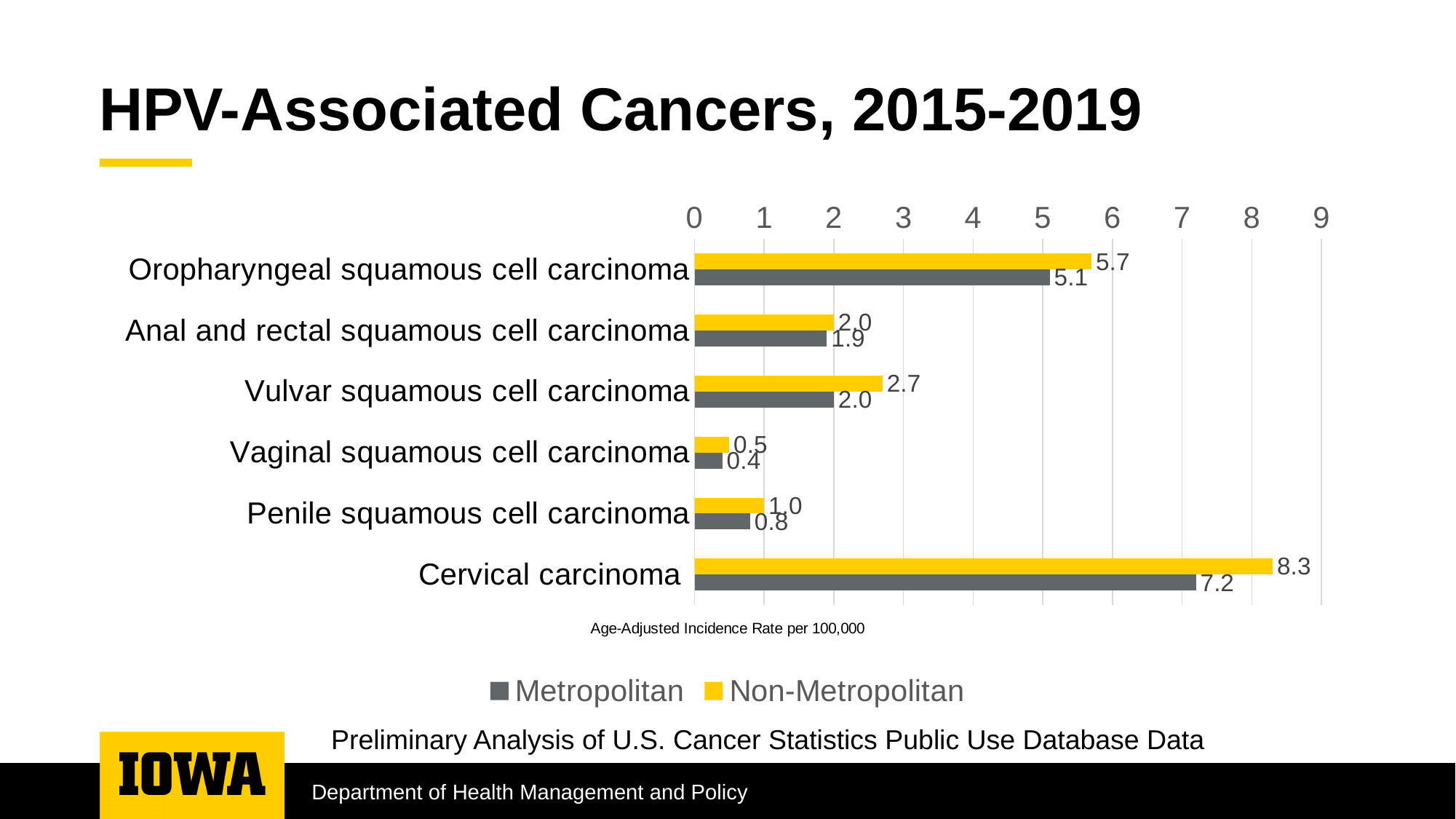
How many cancer types are shown on the chart? 6 What is the Metropolitan age-adjusted incidence rate for oropharyngeal squamous cell carcinoma? 5.1 For penile squamous cell carcinoma, which is larger: the Metropolitan or the Non-Metropolitan rate? Non-Metropolitan Which cancer has the highest Non-Metropolitan incidence rate? Cervical carcinoma What is the difference between the Non-Metropolitan and Metropolitan rates for cervical carcinoma? 1.1 What is the Non-Metropolitan age-adjusted incidence rate for cervical carcinoma? 8.3 Which cancer has the lowest Metropolitan incidence rate? Vaginal squamous cell carcinoma What is the difference between the Non-Metropolitan and Metropolitan rates for vulvar squamous cell carcinoma? 0.7 What kind of chart is shown on the slide? Bar chart What is the Metropolitan value for vaginal squamous cell carcinoma? 0.4 Which colour represents the Non-Metropolitan series? Yellow How many series does the legend list? 2